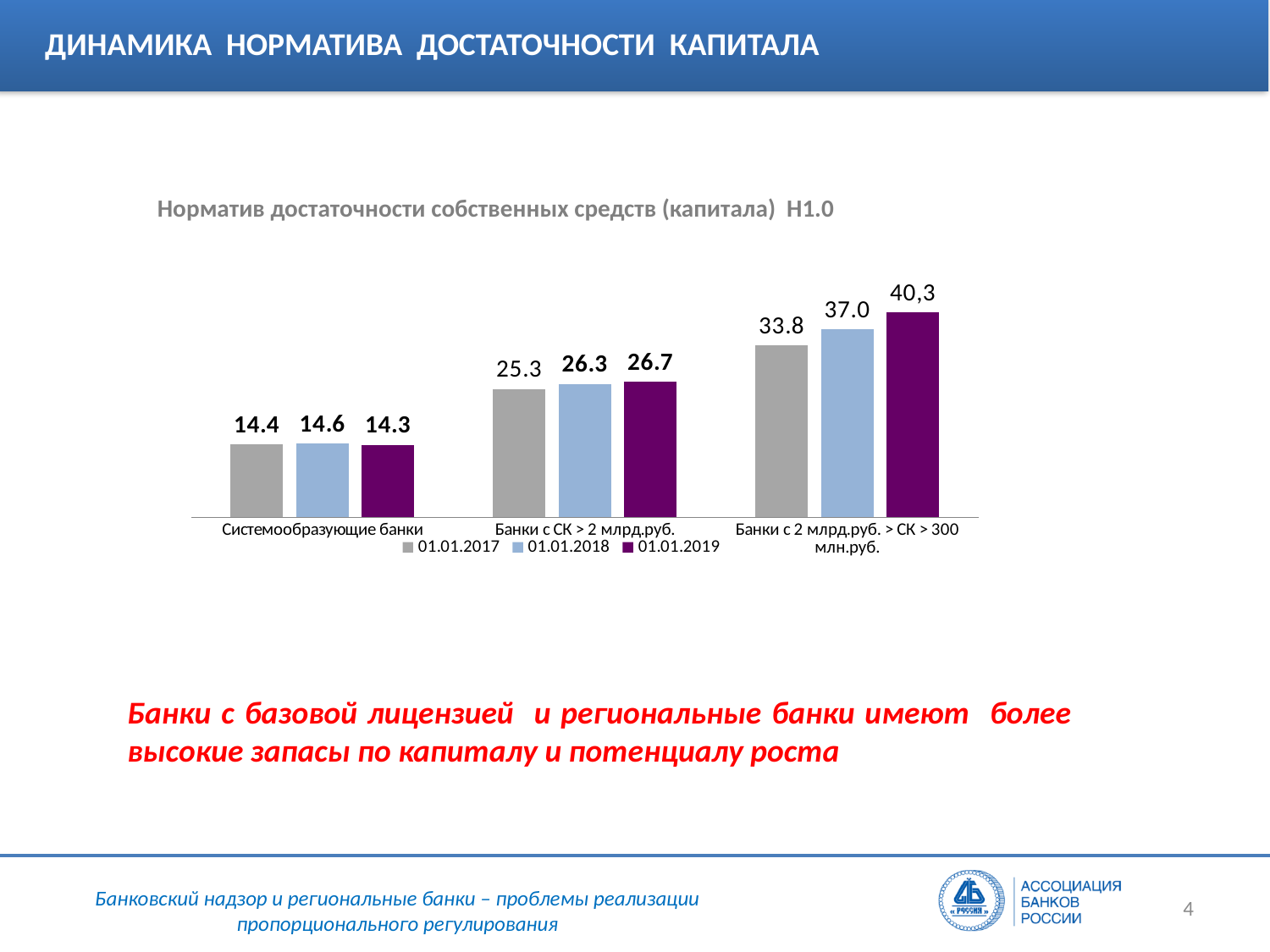
How many categories are shown on the x axis? 3 Which category has the highest value on 01.01.2019? Банки с 2 млрд.руб. > СК > 300 млн.руб. Which is larger for Системообразующие банки: the 01.01.2018 value or the 01.01.2019 value? 01.01.2018 Do the values for Банки с СК > 2 млрд.руб. rise or fall from 01.01.2017 to 01.01.2019? Rise What is the value for Системообразующие банки on 01.01.2018? 14.6 What is the value for Банки с СК > 2 млрд.руб. on 01.01.2019? 26.7 What is the value for Банки с 2 млрд.руб. > СК > 300 млн.руб. on 01.01.2017? 33.8 What kind of chart is shown on the slide? Bar chart What is the difference between the 01.01.2019 and 01.01.2017 values for Банки с 2 млрд.руб. > СК > 300 млн.руб.? 6.5 What is the value for Банки с 2 млрд.руб. > СК > 300 млн.руб. on 01.01.2019? 40,3 Which category has the lowest value on 01.01.2017? Системообразующие банки How many series does the legend list? 3